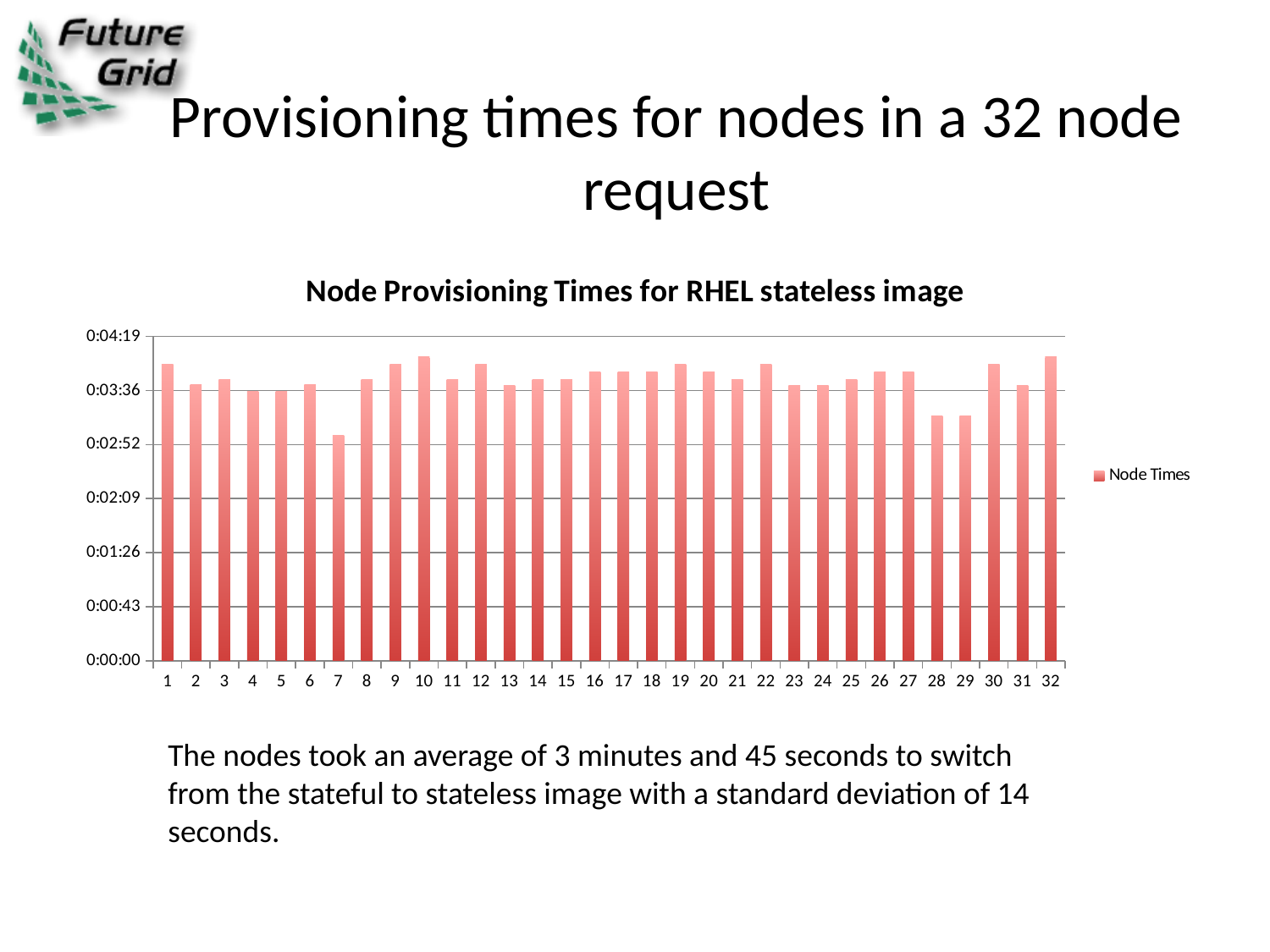
Is the value for node 1 greater or less than 0:03:36? greater Is the value for node 7 greater or less than 0:03:36? less What kind of chart is shown on the slide? bar chart What is the name of the series shown in the legend? Node Times How many nodes (categories) are plotted on the x axis? 32 How many series does the legend list? 1 Is the value for node 10 greater or less than 0:02:52? greater Which node has the lowest provisioning time? 7 Which has the larger provisioning time, node 28 or node 1? node 1 What is the title of the chart? Node Provisioning Times for RHEL stateless image Which has the larger provisioning time, node 7 or node 10? node 10